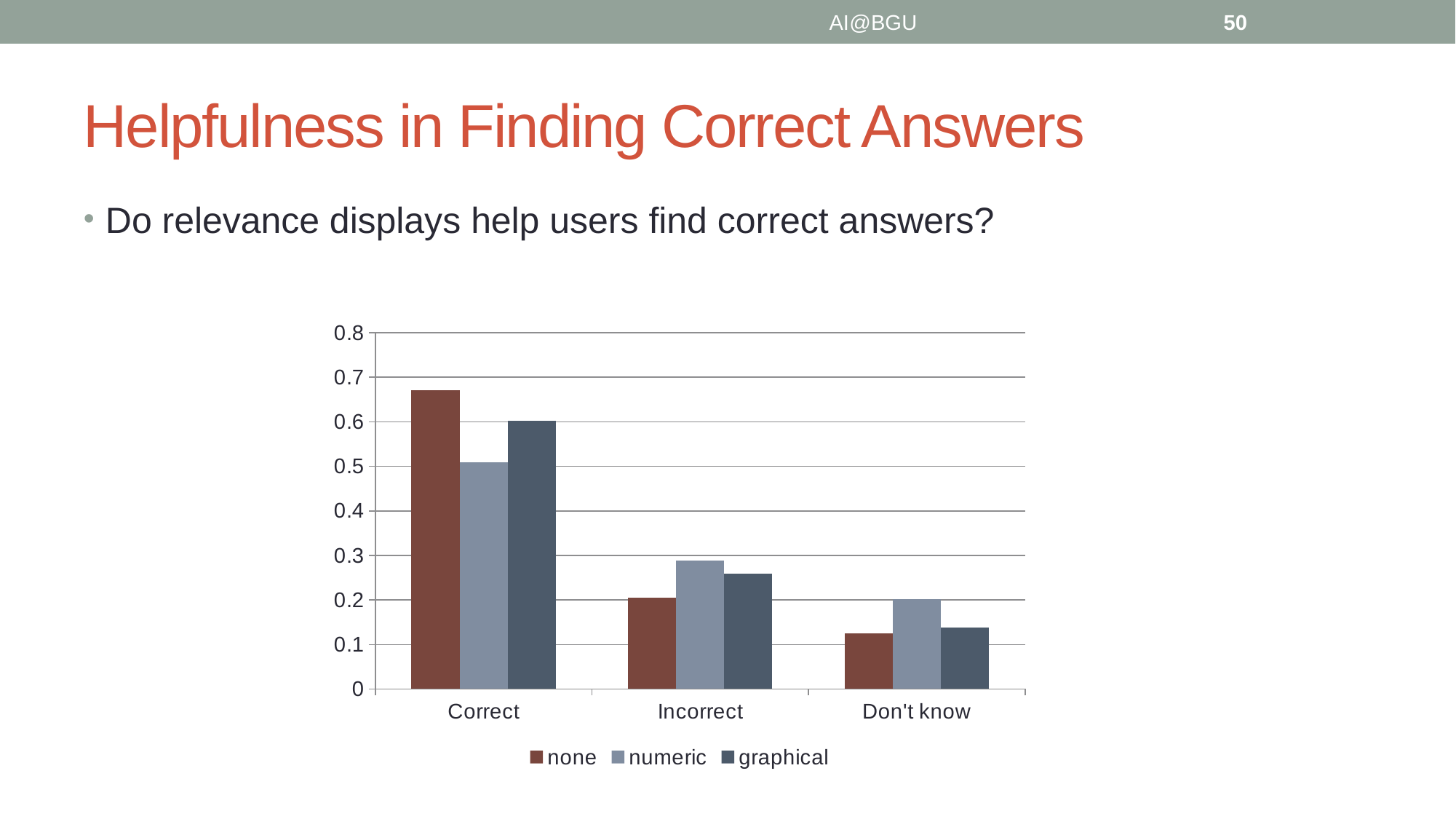
Is the value for none in the Correct category greater or less than 0.6? greater Which series has the lowest value for the Correct category? numeric Which series has the lowest value for the Don't know category? none Which series has the highest value for the Incorrect category? numeric What are the three series listed in the legend? none, numeric, graphical Which is larger: the value for graphical in the Correct category or the value for numeric in the Correct category? graphical Is the value for none in the Don't know category greater or less than 0.1? greater Is the value for graphical in the Incorrect category greater or less than 0.3? less How many series does the legend list? 3 Which series has the highest value for the Correct category? none How many categories are shown on the x axis? 3 What kind of chart is shown on the slide? bar chart